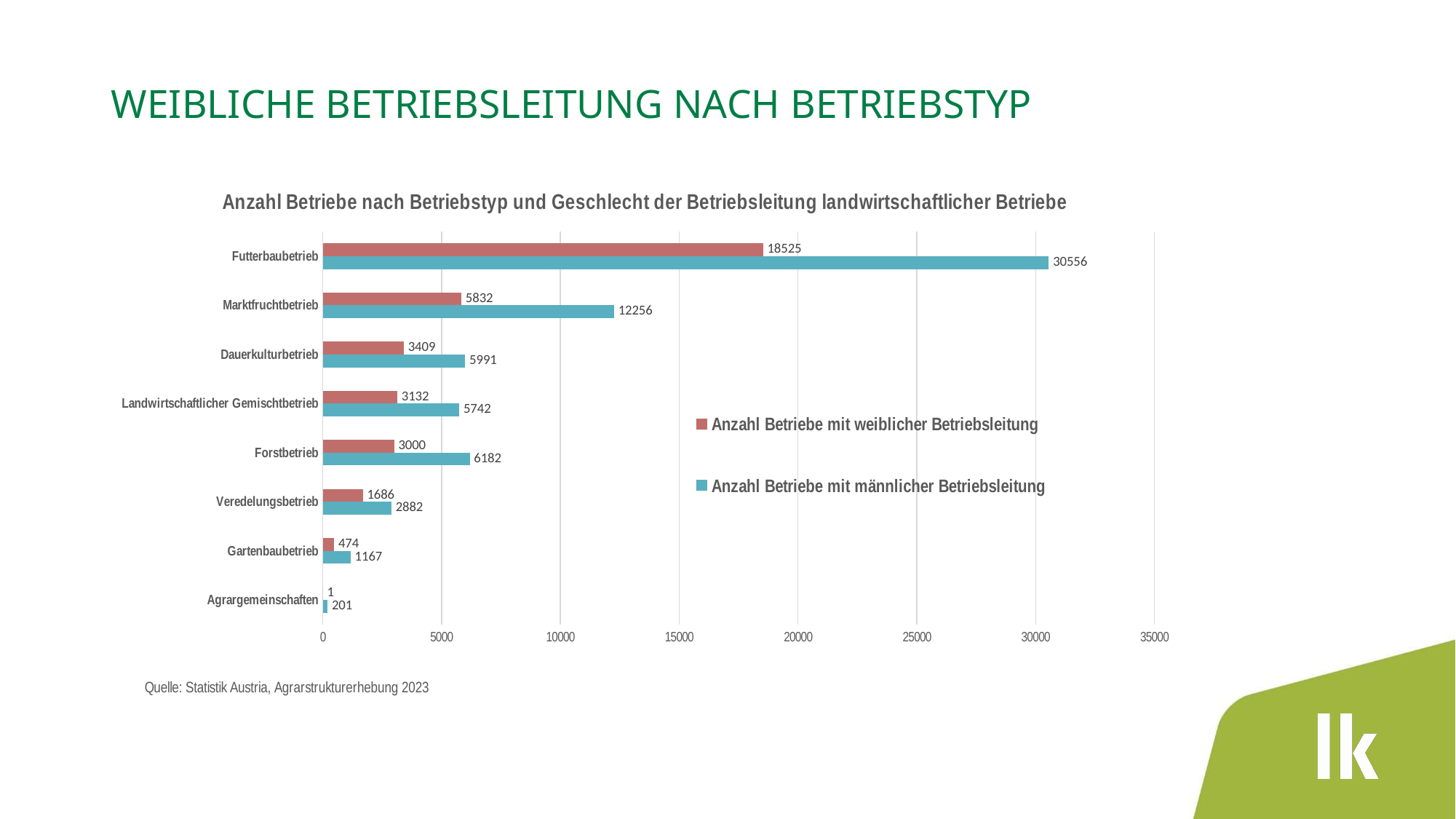
What is the source cited below the chart? Statistik Austria, Agrarstrukturerhebung 2023 Which is larger for Forstbetrieb: the number of Betriebe mit weiblicher Betriebsleitung or mit männlicher Betriebsleitung? Anzahl Betriebe mit männlicher Betriebsleitung What is the difference between the male-led and female-led Betriebe for Futterbaubetrieb? 12031 How many Betriebstypen (categories) are shown on the chart? 8 What is the value for Gartenbaubetrieb in the series Anzahl Betriebe mit weiblicher Betriebsleitung? 474 Is the value for Betriebe mit männlicher Betriebsleitung for Futterbaubetrieb greater or less than 30000? greater How many series does the legend list? 2 Which Betriebstyp has the highest number of Betriebe mit männlicher Betriebsleitung? Futterbaubetrieb Which Betriebstyp has the lowest number of Betriebe mit weiblicher Betriebsleitung? Agrargemeinschaften What is the number of Betriebe mit weiblicher Betriebsleitung for Futterbaubetrieb? 18525 What kind of chart is shown on the slide? Bar chart What is the number of Betriebe mit männlicher Betriebsleitung for Marktfruchtbetrieb? 12256